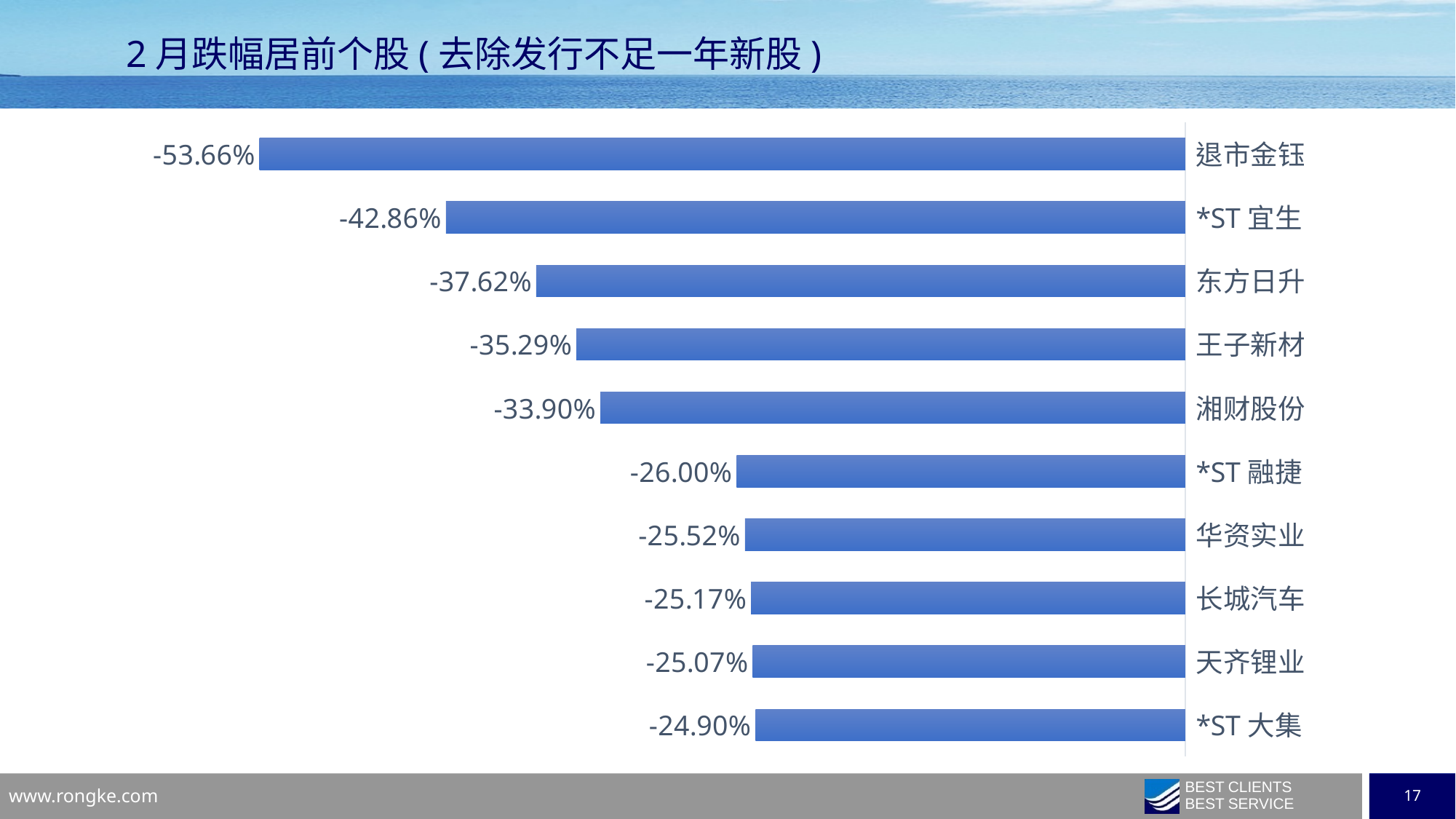
What is the value shown for *ST 大集? -24.90% How many stocks are shown on the chart? 10 By how many percentage points does the decline of 东方日升 exceed that of 王子新材? 2.33 percentage points What kind of chart is shown on the slide? Bar chart What is the value shown for 长城汽车? -25.17% What is the title of the slide? 2 月跌幅居前个股 ( 去除发行不足一年新股 ) By how many percentage points does the decline of 退市金钰 exceed that of *ST 宜生? 10.80 percentage points What is the value shown for 退市金钰? -53.66% Which stock has the smallest decline (the least negative value) on the chart? *ST 大集 What is the value shown for 东方日升? -37.62% Which stock has the largest decline (the most negative value) on the chart? 退市金钰 Which stock fell more in February, 湘财股份 or *ST 融捷? 湘财股份